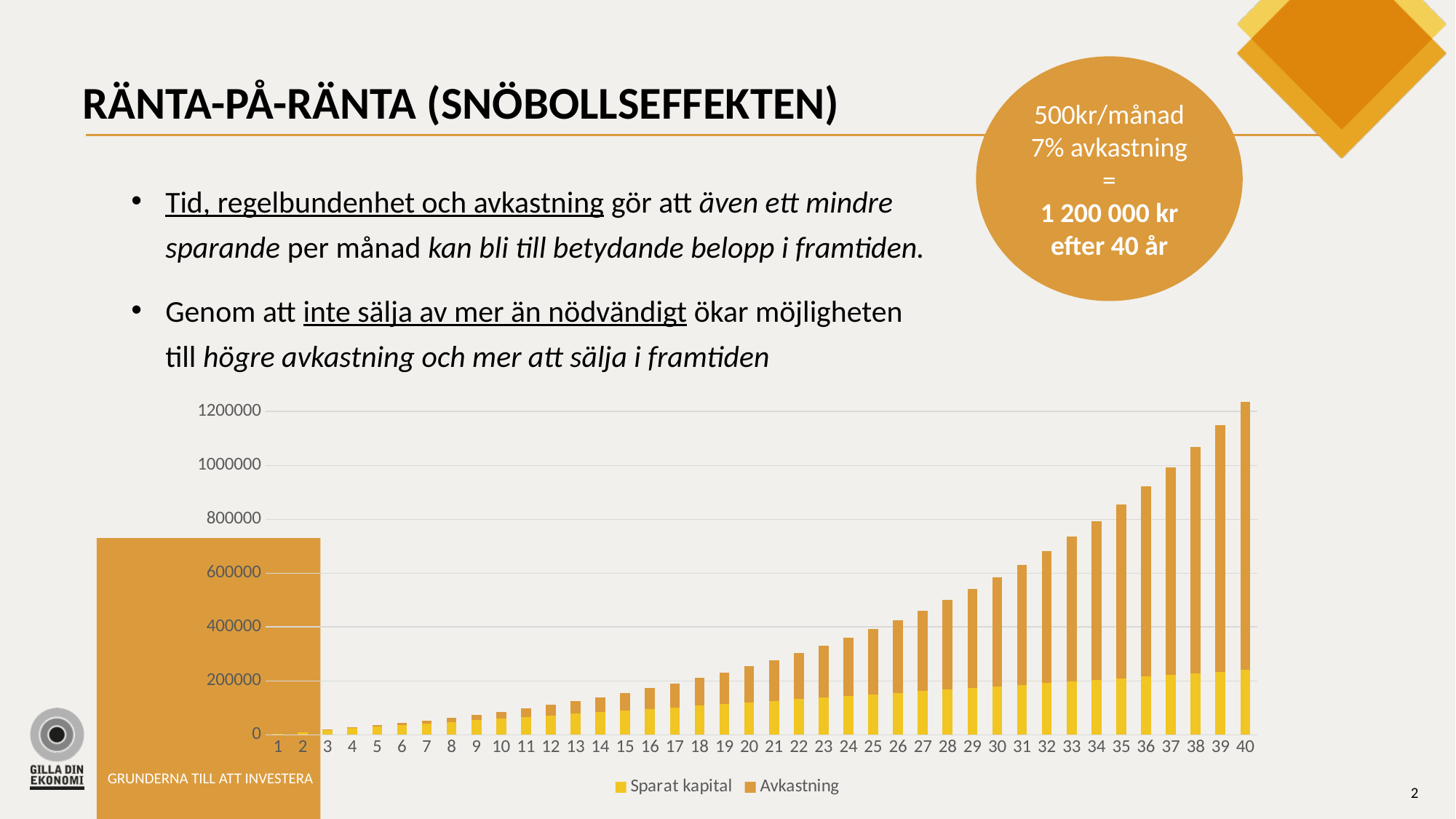
Which year has the lowest total bar in the chart? 1 How many series does the chart legend list? 2 What are the two series named in the chart legend? Sparat kapital and Avkastning Is the total value for year 10 greater or less than 200000? less Is the total value for year 20 greater or less than 200000? greater Which year has the highest total bar in the chart? 40 Do the total bar values rise or fall as the years increase along the x axis? rise What kind of chart is shown on the slide? stacked bar chart Is the total value for year 35 greater or less than 800000? greater Which series is shown in the darker orange colour in the chart? Avkastning How many years (categories) are plotted along the x axis of the chart? 40